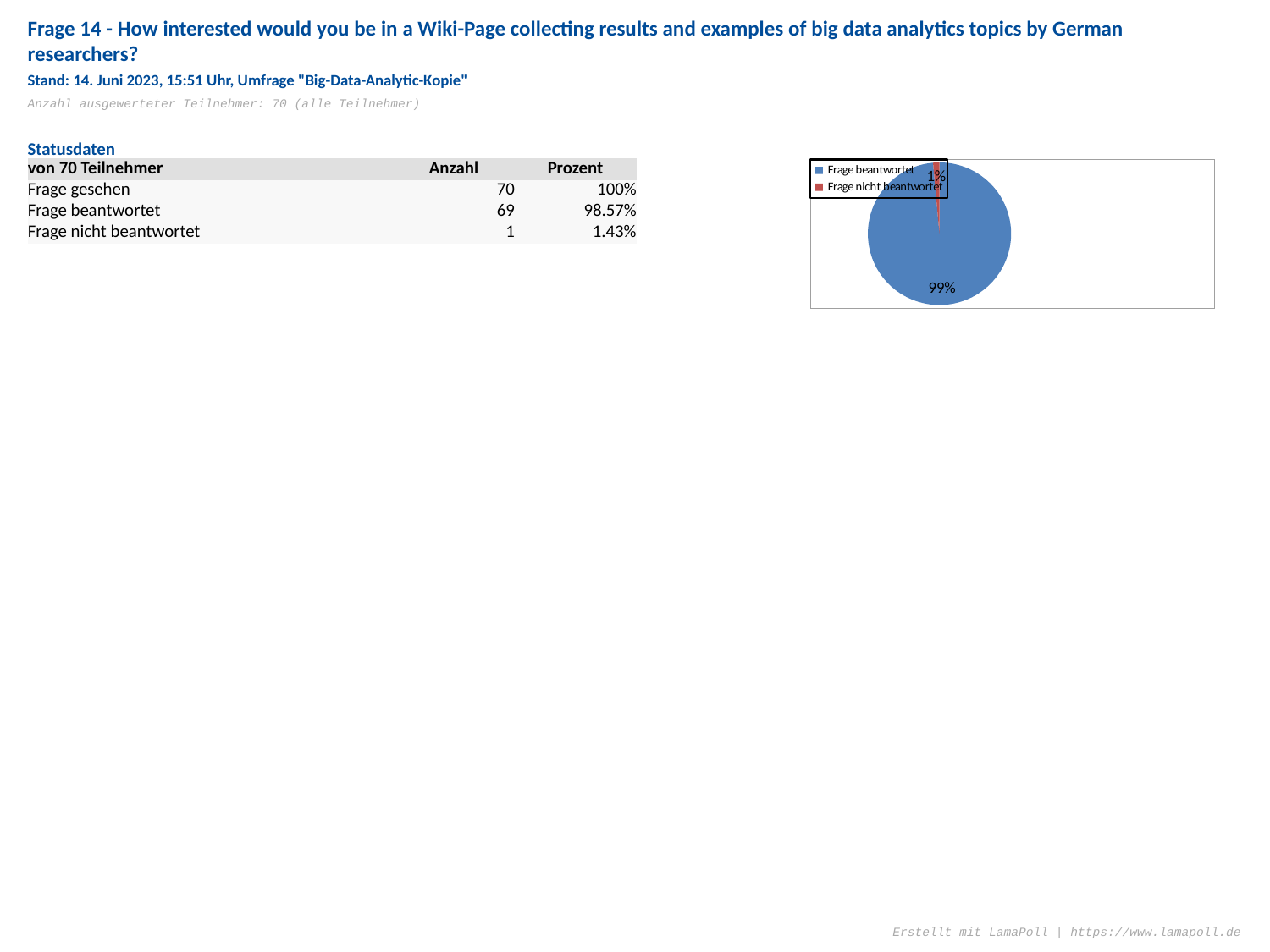
What kind of chart is shown on the slide? pie chart Which slice of the pie chart is the smallest? Frage nicht beantwortet What colour is the "Frage beantwortet" slice in the pie chart? blue Which slice of the pie chart is the largest? Frage beantwortet What is the difference between the percentage labels of the two pie slices? 98% Which is larger in the pie chart: "Frage beantwortet" or "Frage nicht beantwortet"? Frage beantwortet What colour is the "Frage nicht beantwortet" slice in the pie chart? red How many slices does the pie chart have? 2 How many entries does the chart's legend list? 2 What percentage label is shown on the pie slice for "Frage nicht beantwortet"? 1% What percentage label is shown on the pie slice for "Frage beantwortet"? 99%